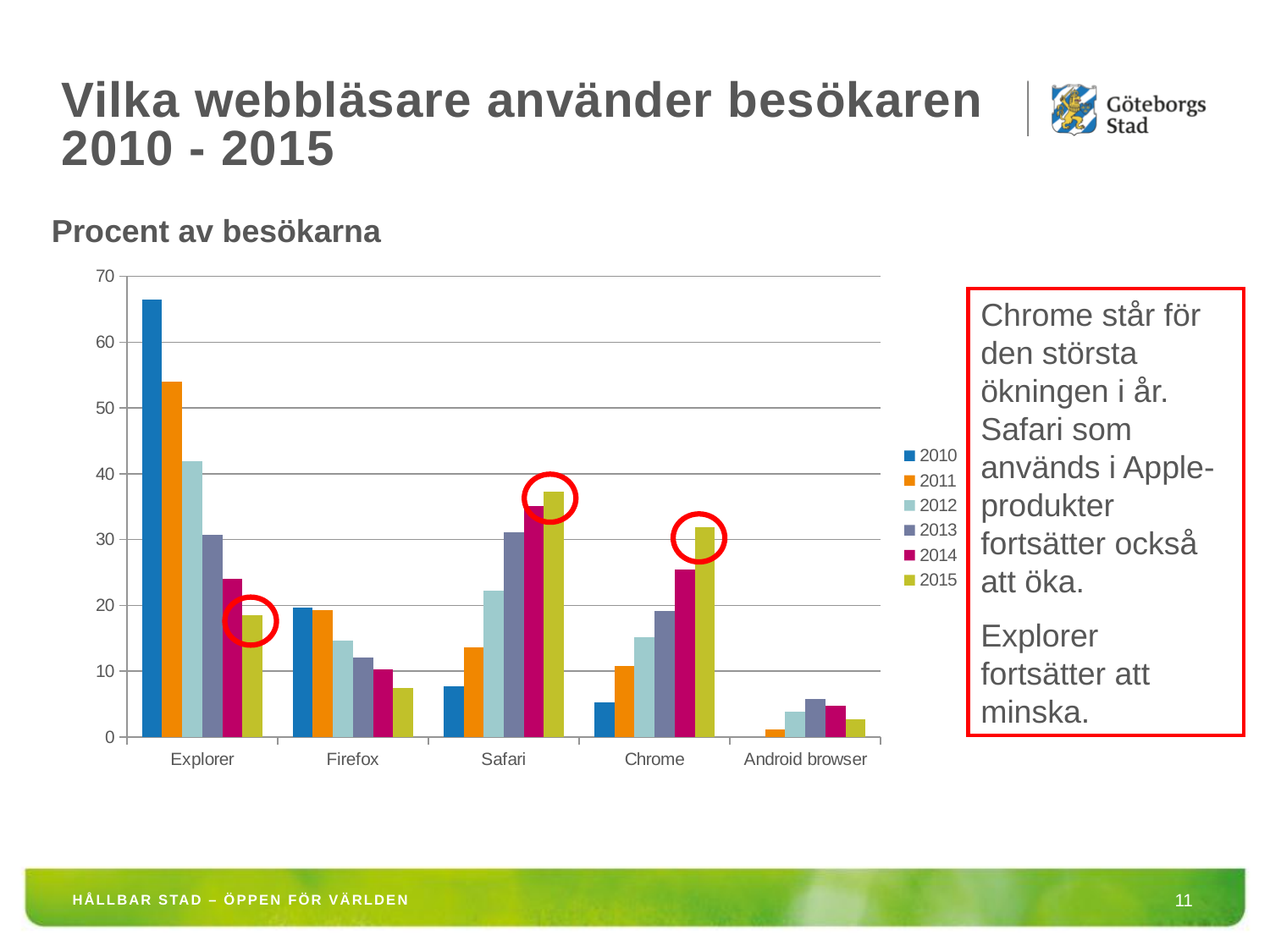
Which is larger in 2015, the value for Safari or the value for Chrome? Safari How many series does the legend list? 6 Is the value for Chrome in 2015 greater or less than 30? greater What kind of chart is shown on the slide? bar chart Do the values for Explorer rise or fall from 2010 to 2015? fall How many browser categories are shown on the x axis? 5 Which browser has the lowest value for 2015? Android browser Which browser has the highest value for 2010? Explorer Is the value for Explorer in 2010 greater or less than 60? greater What is the subtitle shown above the chart? Procent av besökarna Do the values for Safari rise or fall from 2010 to 2015? rise Is the value for Firefox in 2015 greater or less than 10? less